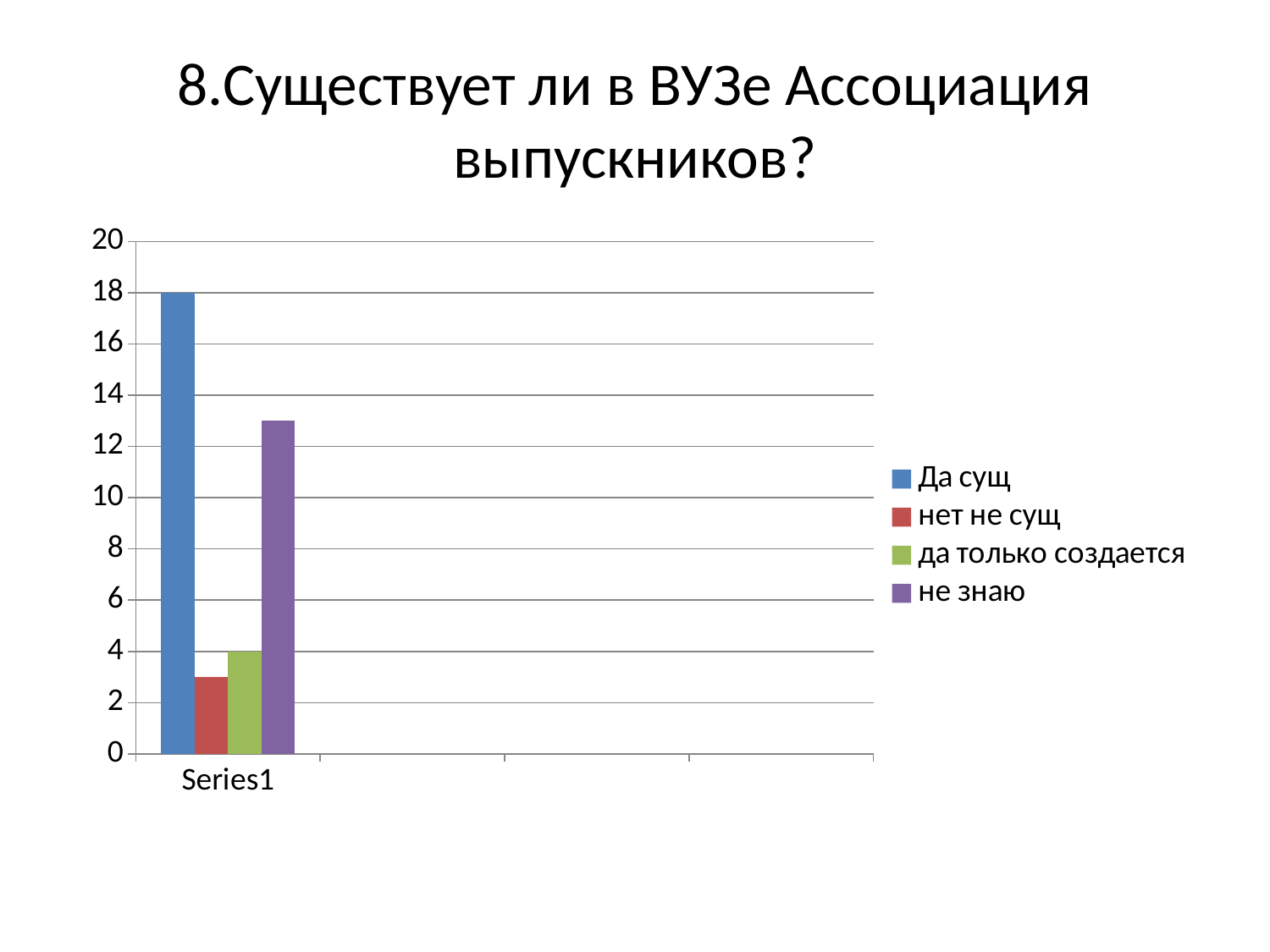
How many series does the legend list? 4 How many bars are plotted in the chart? 4 Is the value for "нет не сущ" greater or less than 4? less Which series has the highest value? Да сущ What is the value for "да только создается"? 4 What is the difference between the value for "Да сущ" and the value for "да только создается"? 14 What kind of chart is shown on the slide? bar chart Is the value for "не знаю" greater or less than 10? greater What colour is the bar for "Да сущ"? blue Which is larger, the value for "не знаю" or the value for "да только создается"? не знаю Which series has the lowest value? нет не сущ What is the value for "Да сущ"? 18